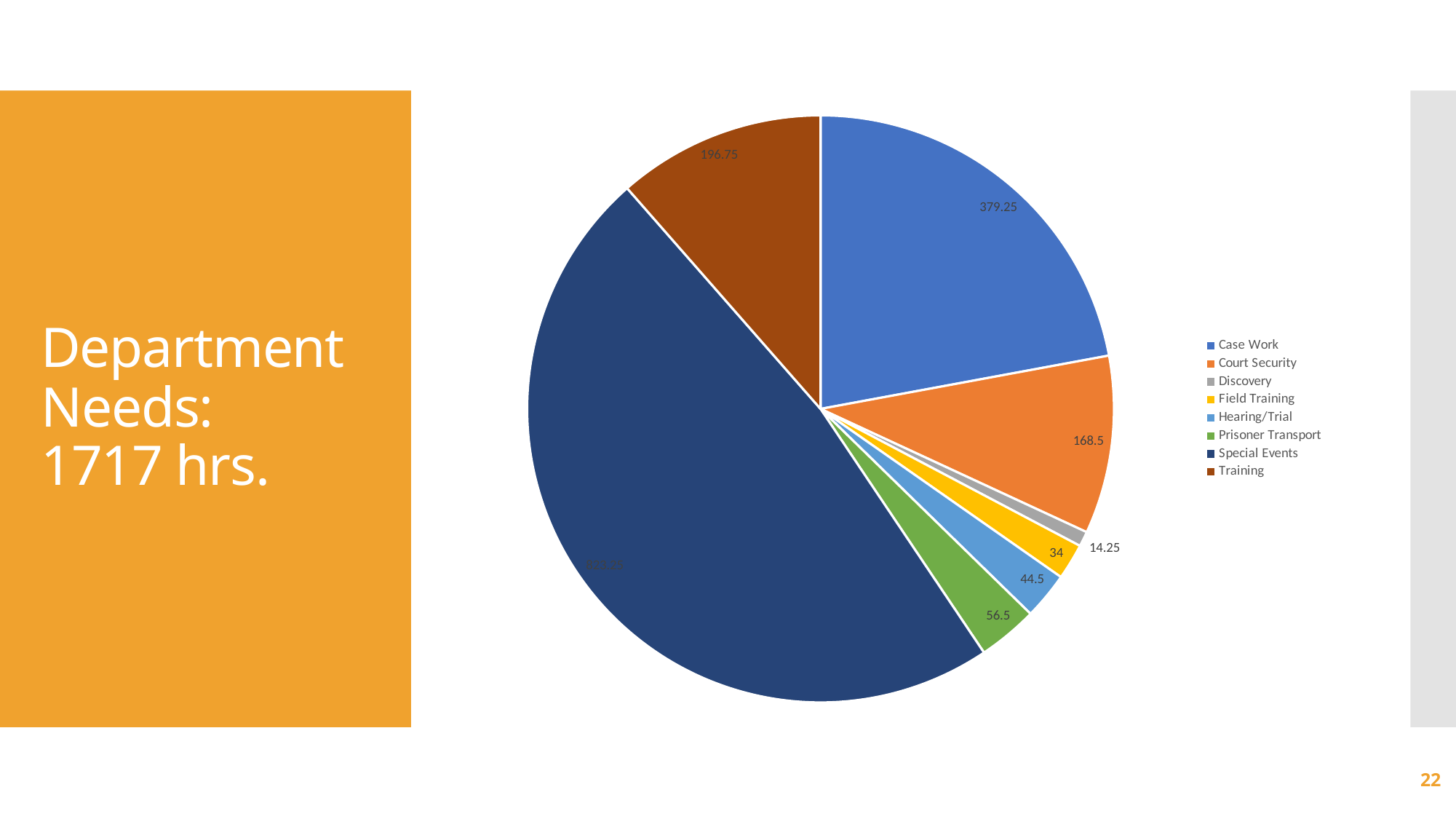
What value is shown for the Discovery slice? 14.25 What value is shown for the Court Security slice? 168.5 What type of chart is shown on the slide? Pie chart Which category has the largest slice of the pie? Special Events What value is shown for the Training slice? 196.75 What value is shown for the Hearing/Trial slice? 44.5 Which category has the smallest slice of the pie? Discovery How many categories does the pie chart show? 8 What value is shown for the Case Work slice? 379.25 Which is larger, the Training slice or the Court Security slice? Training What is the difference between the Case Work value and the Court Security value? 210.75 What value is shown for the Prisoner Transport slice? 56.5